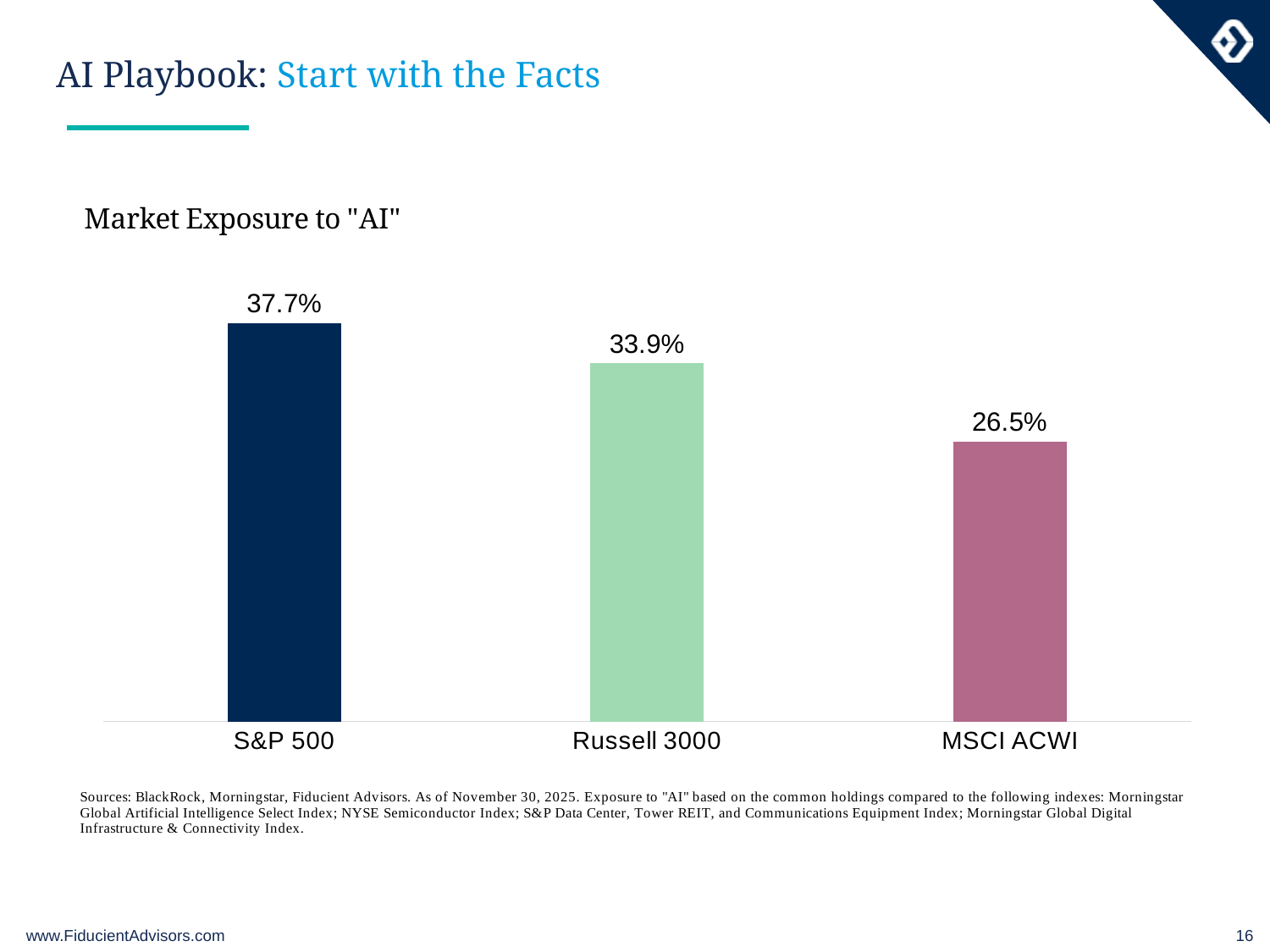
Do the values rise or fall moving from left to right across the chart? Fall What kind of chart is shown on the slide? Bar chart Which has a larger "AI" exposure, the Russell 3000 or the MSCI ACWI? Russell 3000 What is the market exposure to "AI" for the S&P 500? 37.7% How many indexes are shown in the chart? 3 What is the market exposure to "AI" for the MSCI ACWI? 26.5% What is the title of the chart? Market Exposure to "AI" What is the difference in "AI" exposure between the S&P 500 and the MSCI ACWI? 11.2% What is the market exposure to "AI" for the Russell 3000? 33.9% Which index has the highest market exposure to "AI"? S&P 500 What is the difference in "AI" exposure between the S&P 500 and the Russell 3000? 3.8% Which index has the lowest market exposure to "AI"? MSCI ACWI